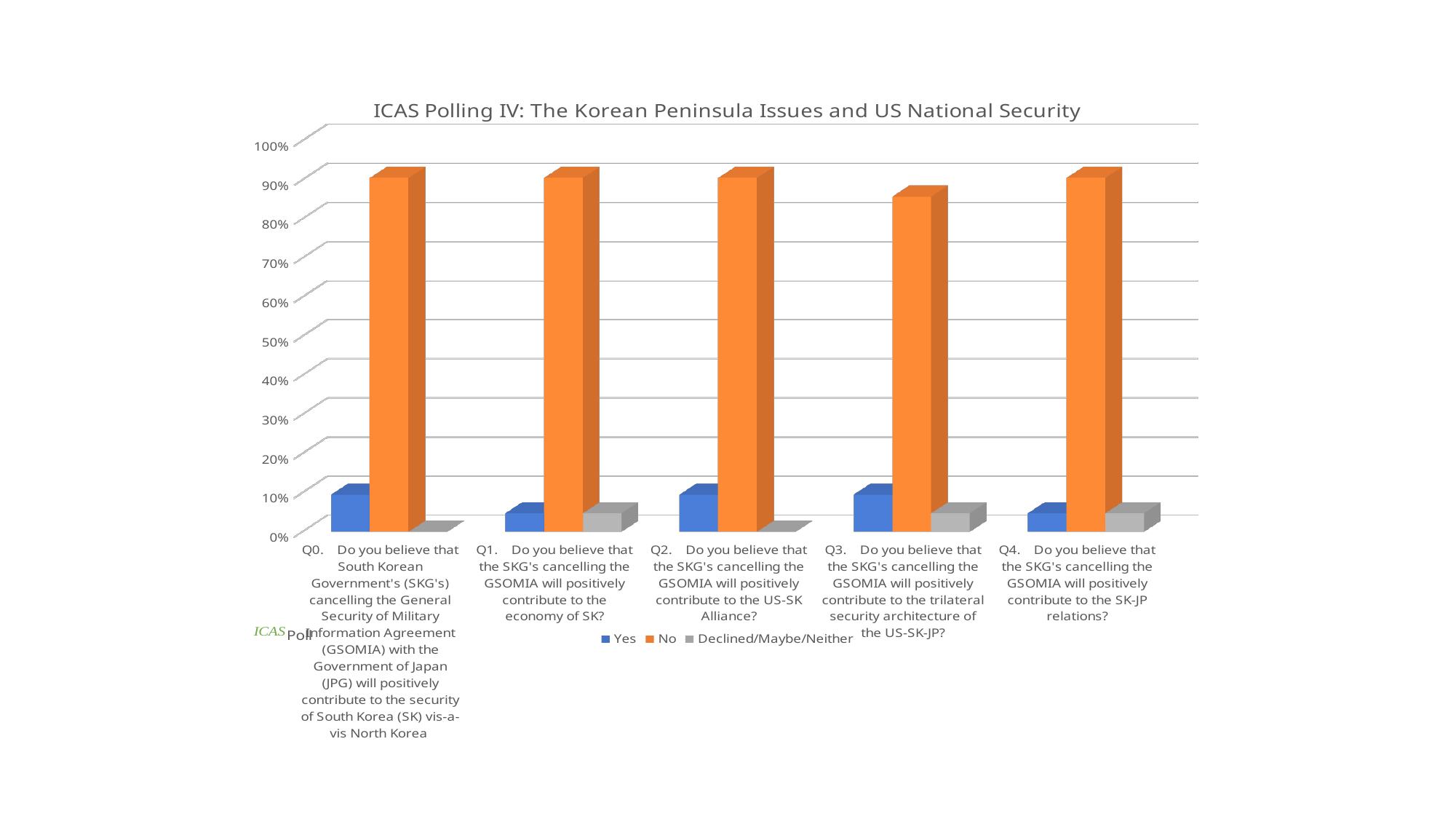
Is the "No" value for Q0 greater or less than 50%? greater What kind of chart is shown on the slide? bar chart Is the "Yes" value for Q0 greater or less than 20%? less Is the "Yes" value for Q1 greater or less than 10%? less How many questions (categories) are plotted along the x axis? 5 Which is larger: the "Yes" value for Q0 or the "Yes" value for Q1? Q0 For which question is the "No" bar the lowest? Q3 Which series is the highest for every question shown? No What is the title of the chart? ICAS Polling IV: The Korean Peninsula Issues and US National Security How many series does the legend list? 3 Which is larger for Q2: the "Yes" value or the "No" value? No